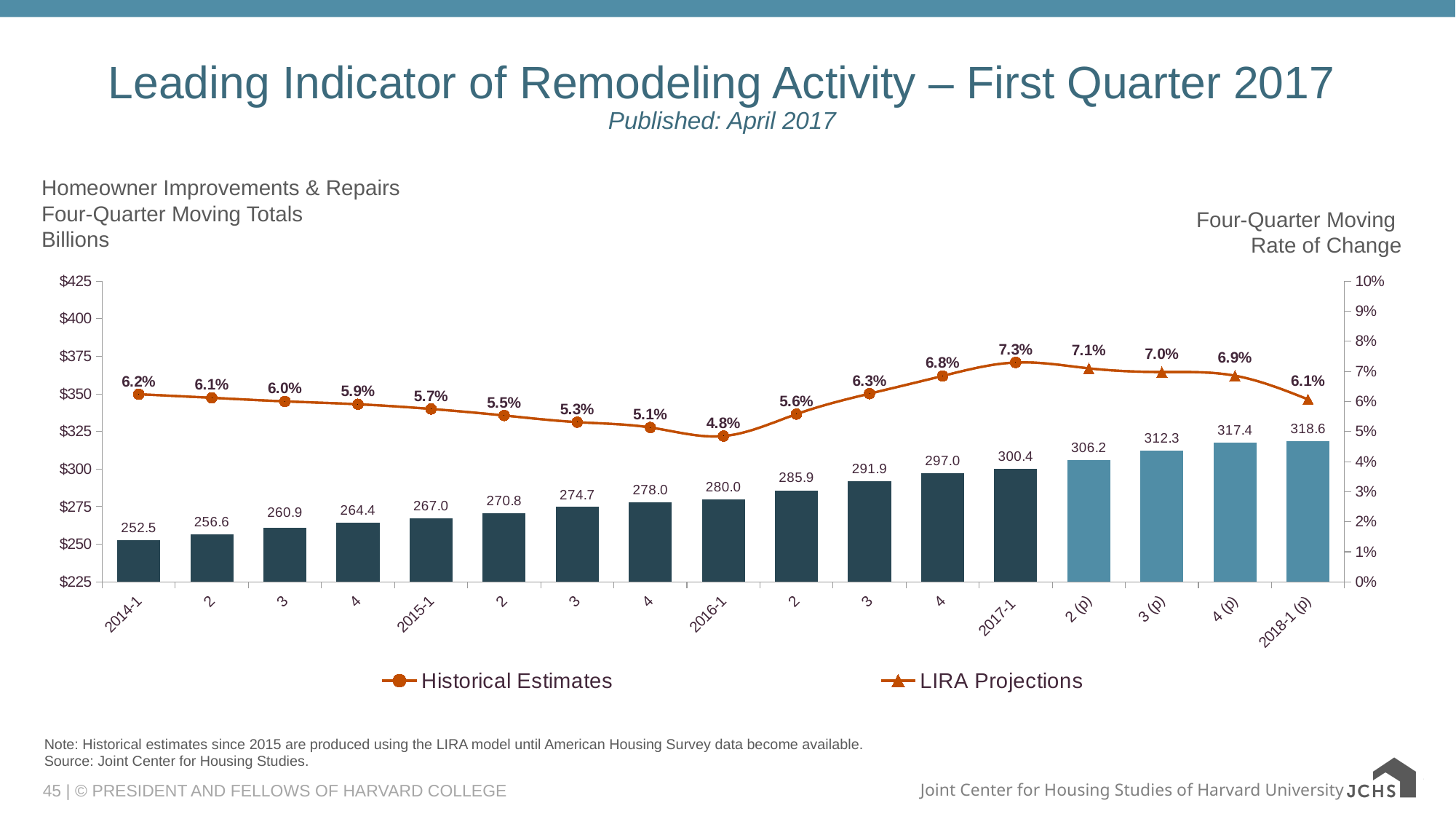
Do the four-quarter moving totals rise or fall from 2014-1 to 2018-1 (p)? rise What are the two series named in the legend? Historical Estimates and LIRA Projections Which is larger, the rate of change for 2014-1 or for 2018-1 (p)? 2014-1 How many quarters are plotted as bars in the chart? 17 Which quarter has the lowest four-quarter moving rate of change? 2016-1 What is the four-quarter moving rate of change shown for 2017-1? 7.3% What is the projected four-quarter moving total for 2018-1 (p)? 318.6 How many series does the legend list? 2 What is the four-quarter moving total (in billions) for 2016-1? 280.0 Which quarter has the lowest four-quarter moving total? 2014-1 Which quarter has the highest four-quarter moving rate of change? 2017-1 What is the difference between the four-quarter moving totals for 2017-1 and 2014-1? 47.9